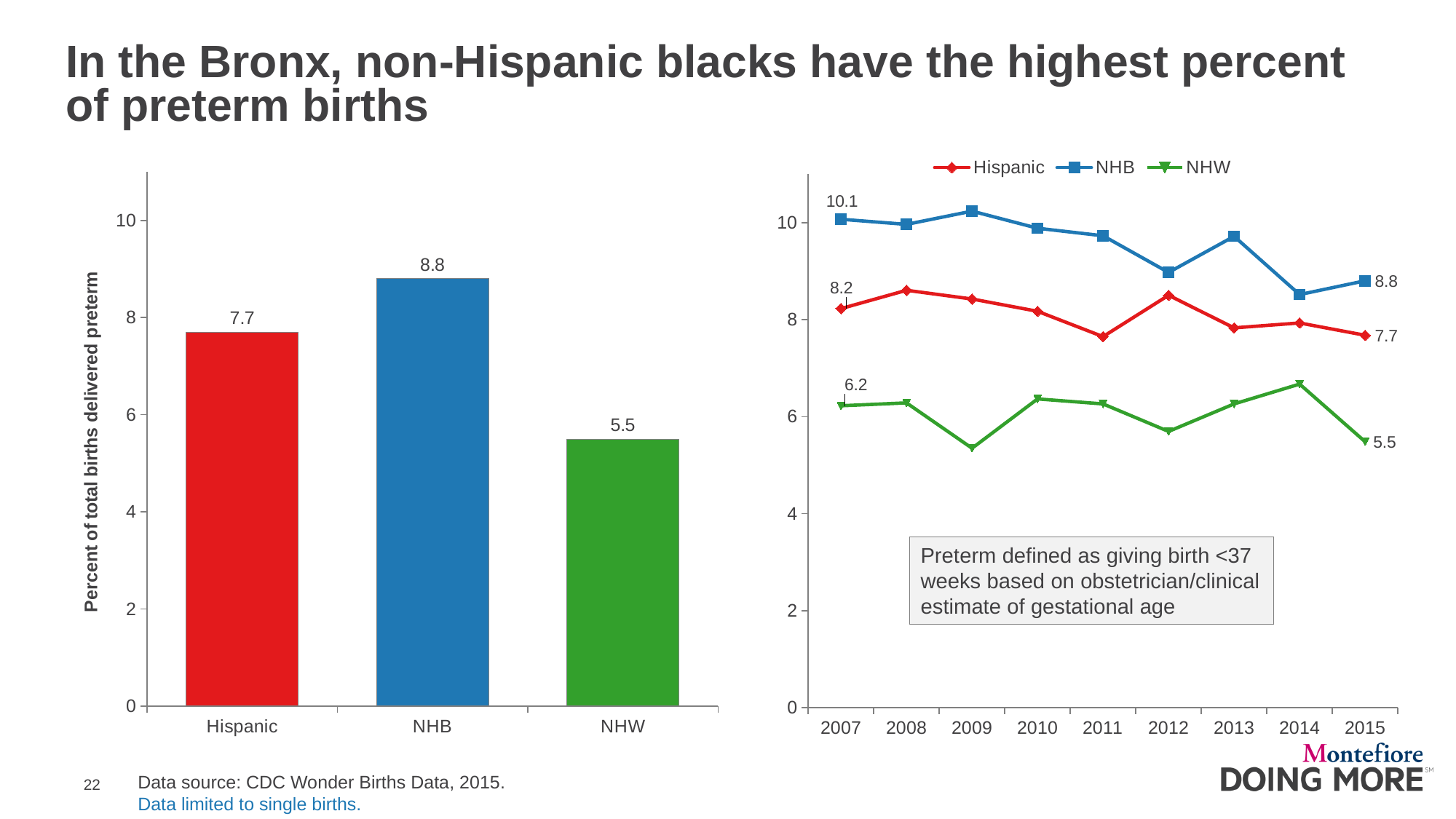
In the line chart on the right, is the NHW value for 2009 greater or less than 6? less In the line chart on the right, what is the NHW value in 2015? 5.5 In the line chart on the right, what is the NHB value in 2007? 10.1 In the line chart on the right, does the NHB series rise or fall from 2007 to 2015? Fall In the line chart on the right, how many series does the legend list? 3 What kind of chart is on the left of the slide? Bar chart In the bar chart on the left, what is the difference between the NHB and NHW values? 3.3 In the bar chart on the left, what is the value for NHB? 8.8 In the bar chart on the left, which category has the lowest percent of preterm births? NHW In the bar chart on the left, which category has the highest percent of preterm births? NHB In the bar chart on the left, what is the value for Hispanic? 7.7 In the bar chart on the left, how many categories are shown? 3